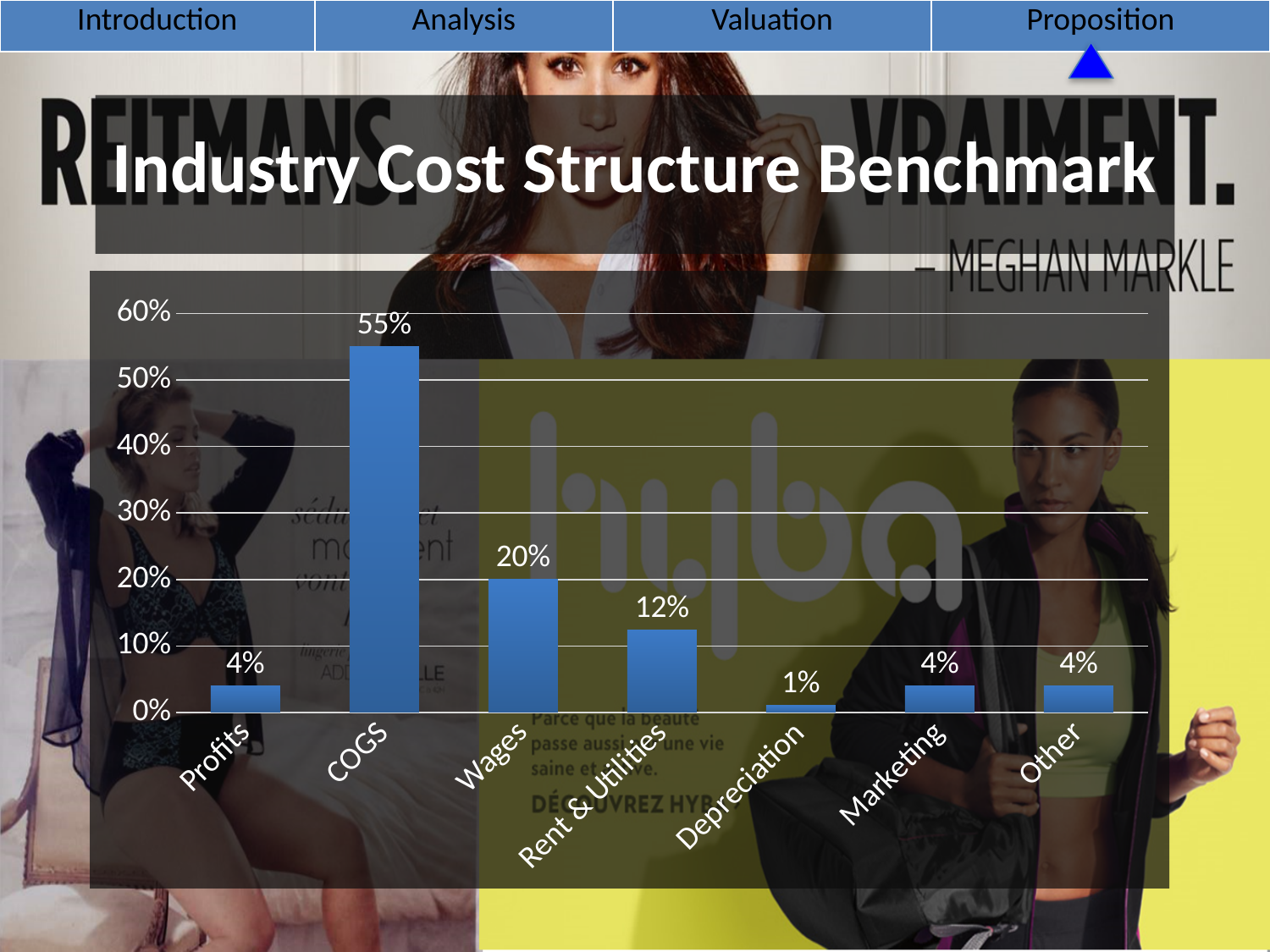
What kind of chart is shown on the slide? bar chart What is the title of the slide? Industry Cost Structure Benchmark What is the value for Wages? 20% What is the value for Depreciation? 1% How many categories are shown on the x axis? 7 What is the value for COGS? 55% Which category has the lowest value? Depreciation Which category has the highest value? COGS Which is larger, the value for Wages or the value for Rent & Utilities? Wages Is the value for COGS greater or less than 50%? greater What is the difference between the values for COGS and Wages? 35% What is the value for Rent & Utilities? 12%